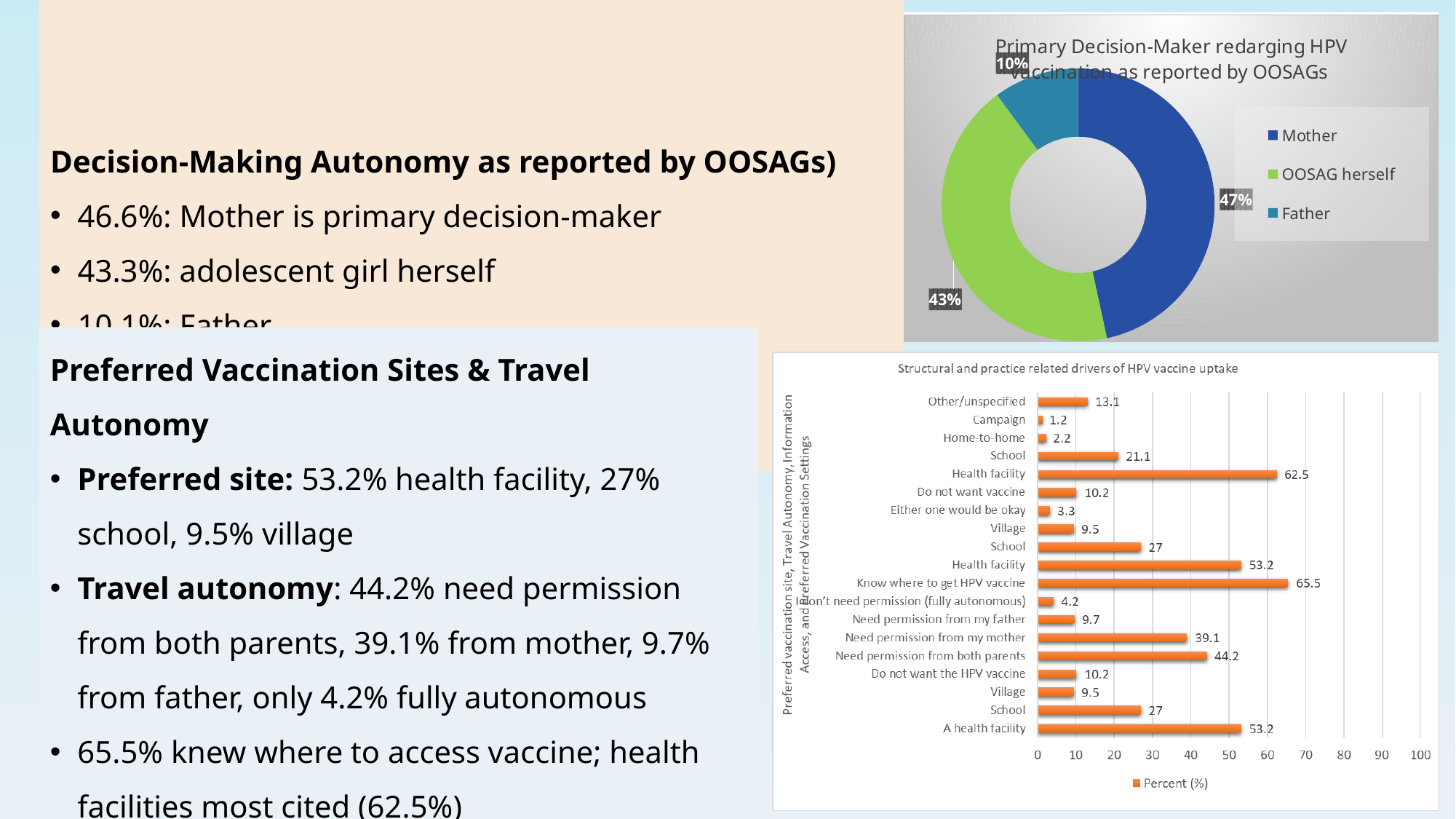
How many categories does the legend of the 'Primary Decision-Maker' doughnut chart list? 3 In the 'Primary Decision-Maker' doughnut chart, which category has the smallest share? Father In the 'Primary Decision-Maker' doughnut chart, what share is labelled for Mother? 47% In the 'Structural and practice related drivers of HPV vaccine uptake' chart, what is the difference between 'Need permission from my mother' and 'Need permission from my father'? 29.4 What kind of chart is 'Structural and practice related drivers of HPV vaccine uptake'? Bar chart In the 'Structural and practice related drivers of HPV vaccine uptake' chart, what is the value for 'Need permission from both parents'? 44.2 In the 'Structural and practice related drivers of HPV vaccine uptake' chart, which category has the lowest value? Campaign In the 'Structural and practice related drivers of HPV vaccine uptake' chart, what is the value for 'Know where to get HPV vaccine'? 65.5 In the 'Structural and practice related drivers of HPV vaccine uptake' chart, which is larger: 'Other/unspecified' or 'Home-to-home'? Other/unspecified What kind of chart is the 'Primary Decision-Maker' chart at the top right? Doughnut chart In the 'Structural and practice related drivers of HPV vaccine uptake' chart, which category has the highest value? Know where to get HPV vaccine In the 'Primary Decision-Maker' doughnut chart, what share is labelled for Father? 10%